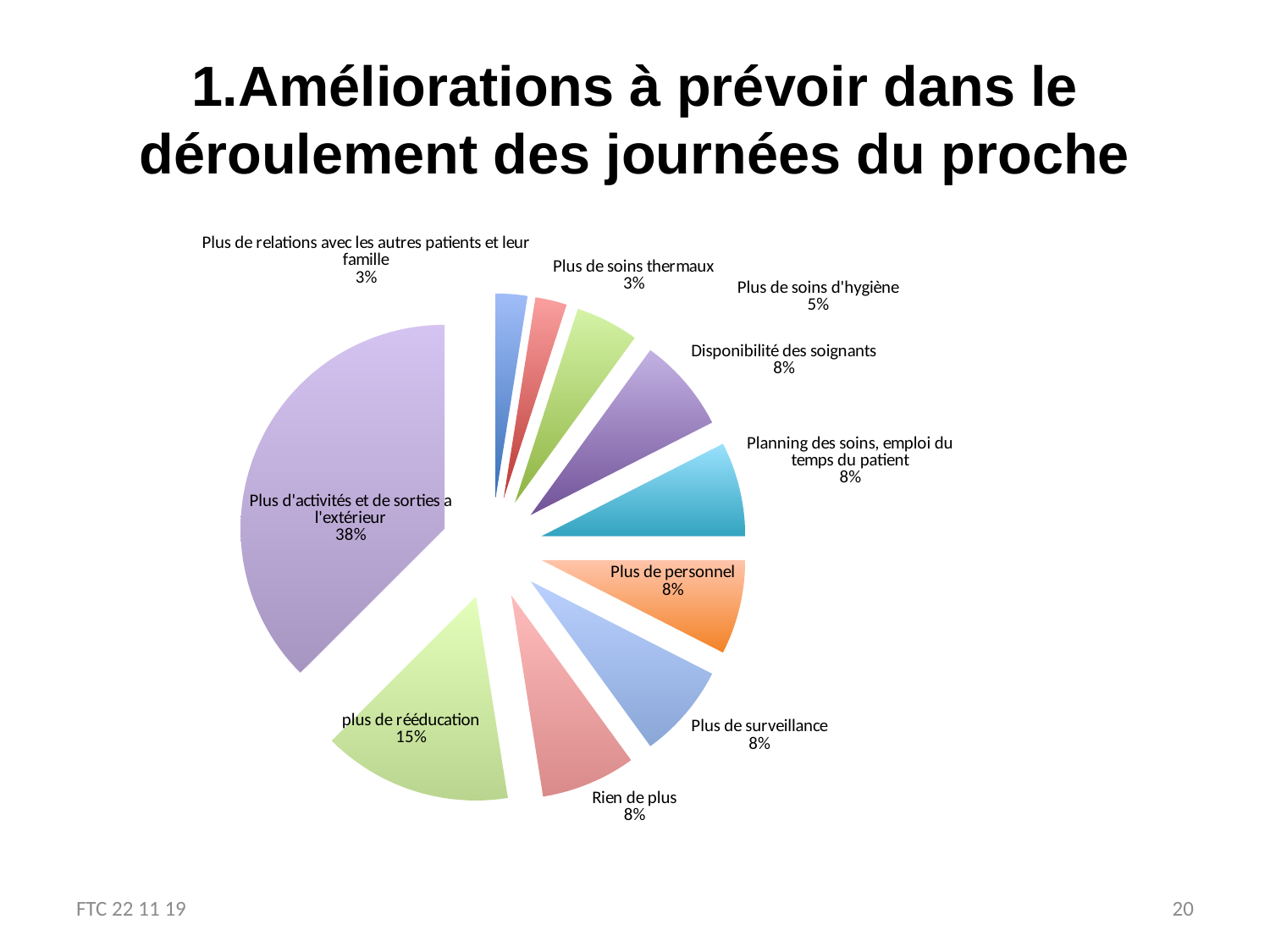
What percentage is shown for "plus de rééducation"? 15% What kind of chart is shown on the slide? pie chart What is the difference in percentage points between "plus de rééducation" and "Plus de personnel"? 7 What percentage is shown for "Plus de soins thermaux"? 3% What share of the pie does "Plus d'activités et de sorties a l'extérieur" represent? 38% What is the title of the slide containing the pie chart? 1.Améliorations à prévoir dans le déroulement des journées du proche How many slices does the pie chart have? 10 What percentage is shown for "Plus de soins d'hygiène"? 5% Which is larger, "Plus de soins d'hygiène" or "Plus de soins thermaux"? Plus de soins d'hygiène Which category has the largest slice of the pie? Plus d'activités et de sorties a l'extérieur What percentage is shown for "Rien de plus"? 8% What is the difference in percentage points between "Plus d'activités et de sorties a l'extérieur" and "plus de rééducation"? 23